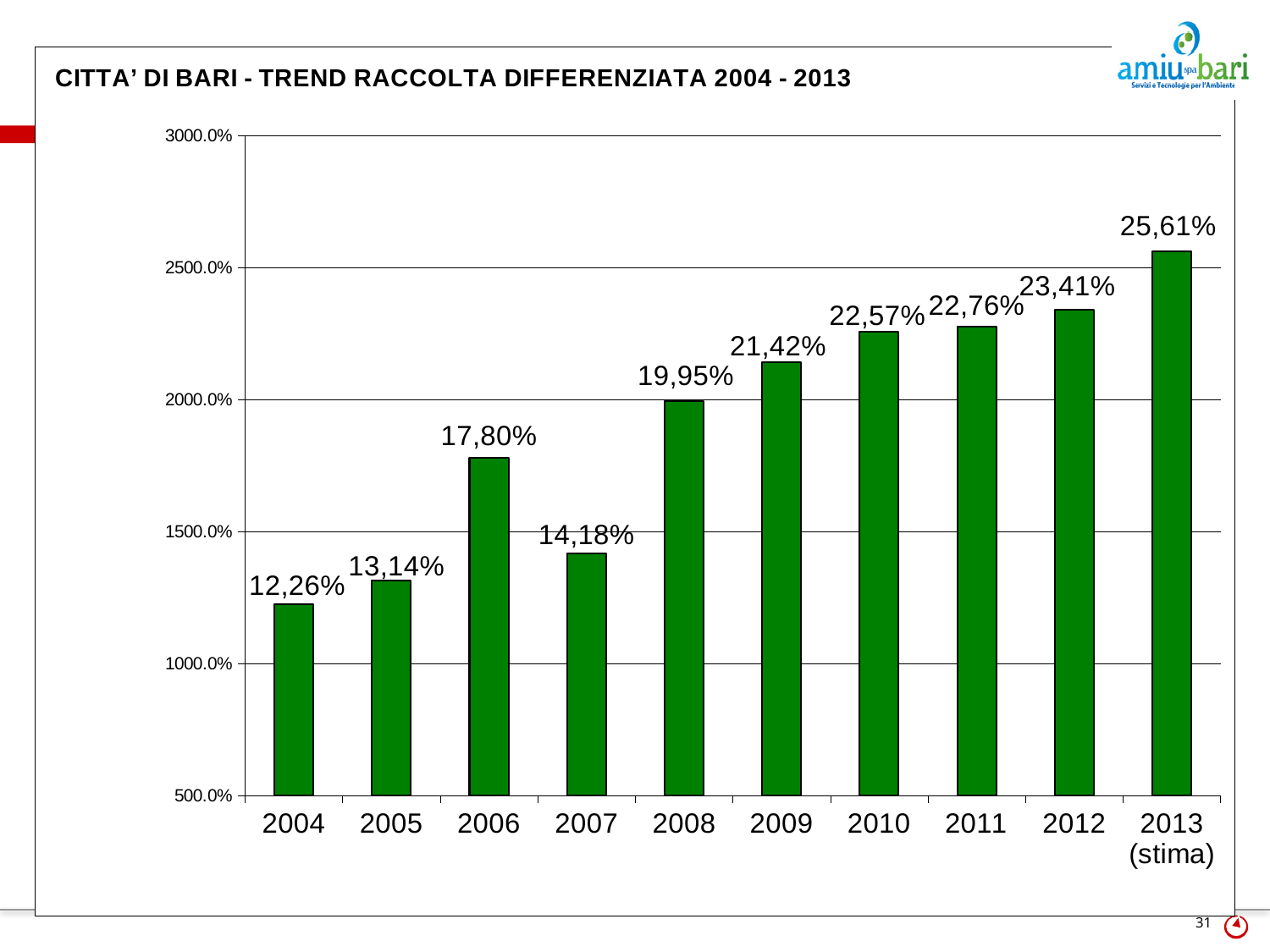
What is the difference between the values for 2013 (stima) and 2004? 13,35% What kind of chart is shown on the slide? bar chart What is the value shown for 2007? 14,18% What is the value shown for 2013 (stima)? 25,61% Which year has the highest value? 2013 (stima) What is the value shown for 2010? 22,57% How many years are plotted on the chart? 10 Which is larger, the value for 2006 or the value for 2007? 2006 Do the values generally rise or fall from 2004 to 2013? rise Which year has the lowest value? 2004 What is the value shown for 2004? 12,26% What is the title of the chart? CITTA' DI BARI - TREND RACCOLTA DIFFERENZIATA 2004 - 2013